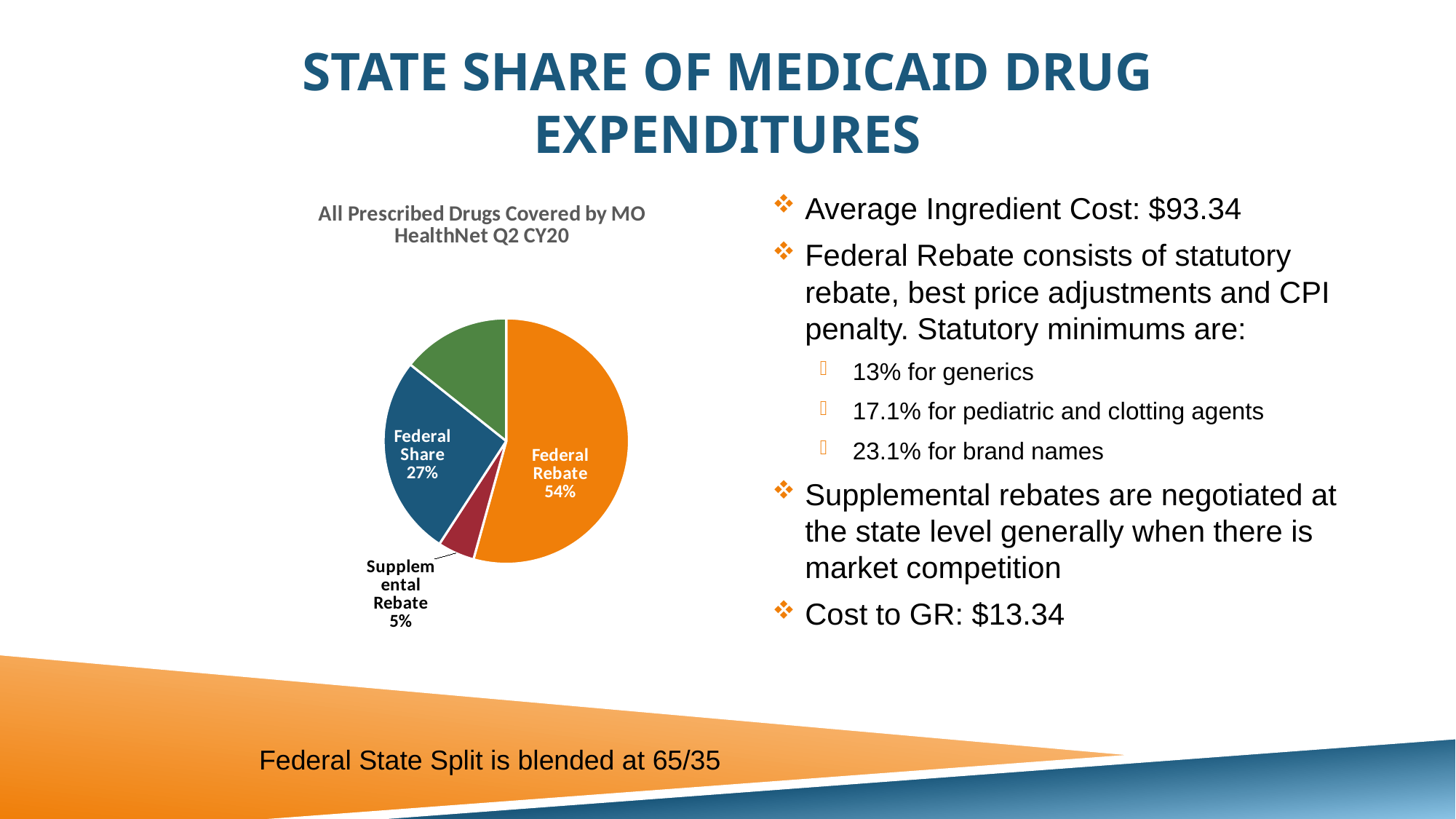
Which slice of the pie chart is the smallest? Supplemental Rebate Which slice of the pie chart is the largest? Federal Rebate What percentage of the pie is Federal Rebate? 54% What is the difference in percentage points between the Federal Rebate slice and the Federal Share slice? 27 percentage points How many slices does the pie chart have? 4 Which is larger, the Federal Share slice or the Supplemental Rebate slice? Federal Share What percentage of the pie is Federal Share? 27% What percentage of the pie is Supplemental Rebate? 5% What colour is the Federal Rebate slice? Orange What kind of chart is shown on the slide? Pie chart What is the difference in percentage points between the Federal Share slice and the Supplemental Rebate slice? 22 percentage points What is the title of the pie chart? All Prescribed Drugs Covered by MO HealthNet Q2 CY20